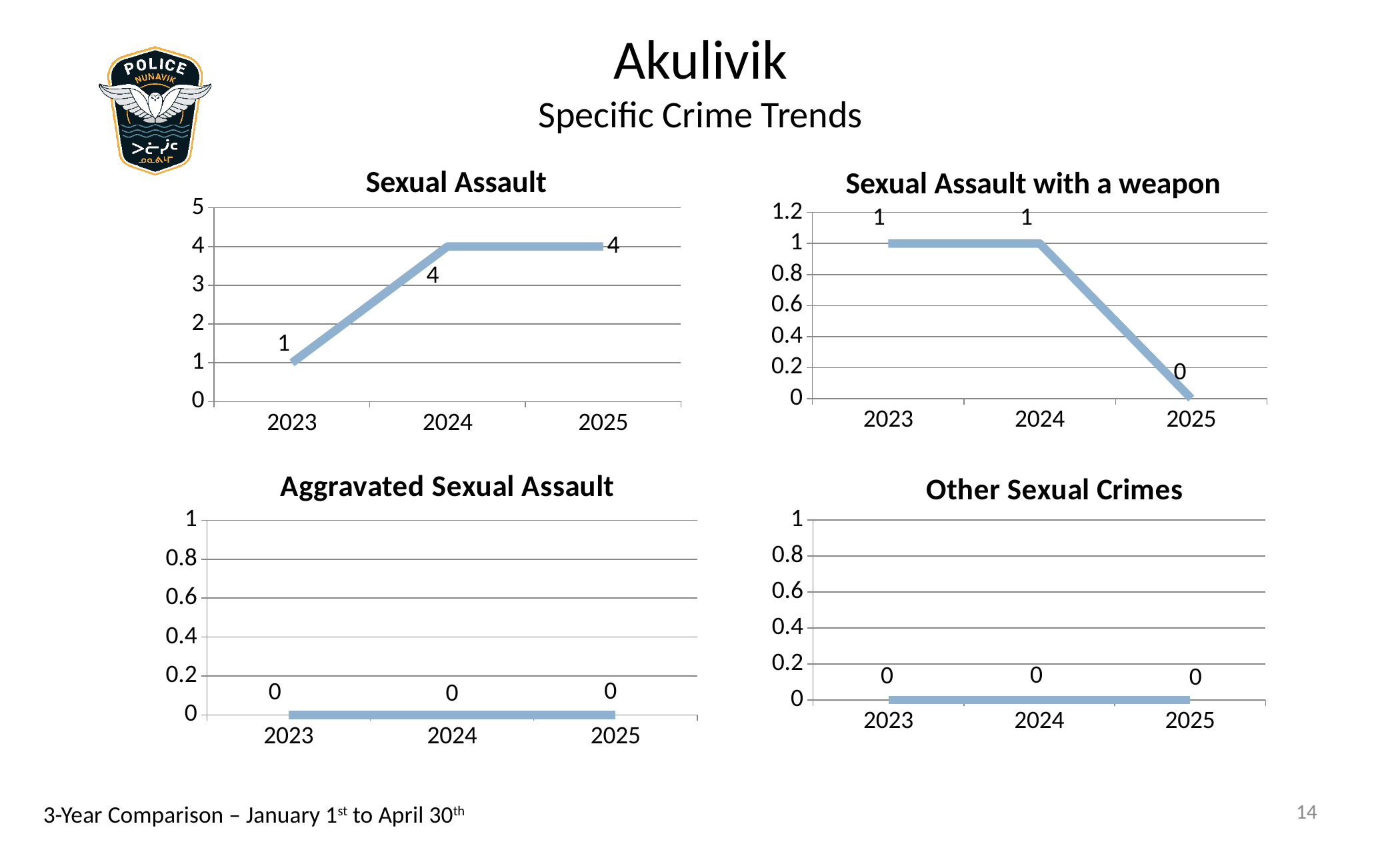
In the Sexual Assault chart, what is the value for 2023? 1 What kind of chart is the Sexual Assault chart? line chart In the Sexual Assault with a weapon chart, is the value for 2023 larger or smaller than the value for 2025? larger In the Sexual Assault chart, which year has the lowest value? 2023 In the Aggravated Sexual Assault chart, what is the value for 2024? 0 In the Sexual Assault with a weapon chart, which year has the lowest value? 2025 In the Other Sexual Crimes chart, how many years are plotted? 3 In the Sexual Assault chart, what is the value for 2025? 4 In the Sexual Assault with a weapon chart, do the values rise or fall from 2024 to 2025? fall In the Sexual Assault with a weapon chart, what is the value for 2024? 1 In the Sexual Assault chart, what is the difference between the 2024 and 2023 values? 3 In the Sexual Assault with a weapon chart, what is the value for 2025? 0